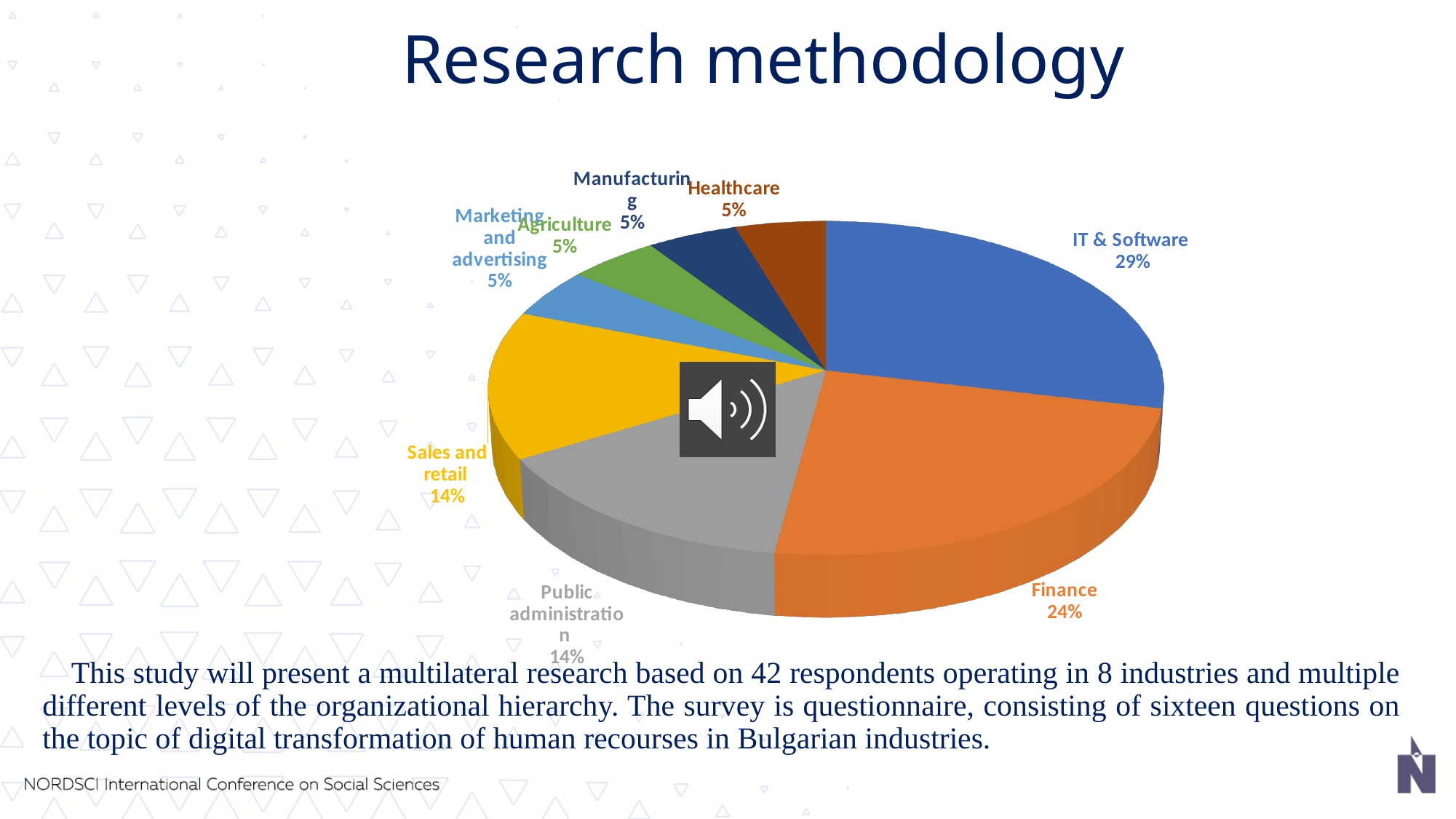
What share of respondents is in Healthcare? 5% Which industry has the largest share of the pie? IT & Software What colour is the Finance slice? orange How many industries each have a 5% share? 4 What kind of chart is shown on the slide? pie chart What share of respondents is in Finance? 24% What is the combined share of IT & Software and Finance? 53% What share of respondents is in Public administration? 14% Which is larger, the share for Sales and retail or the share for Agriculture? Sales and retail What share of respondents is in IT & Software? 29% What is the difference between the IT & Software share and the Finance share? 5% How many industries (slices) are shown in the pie chart? 8